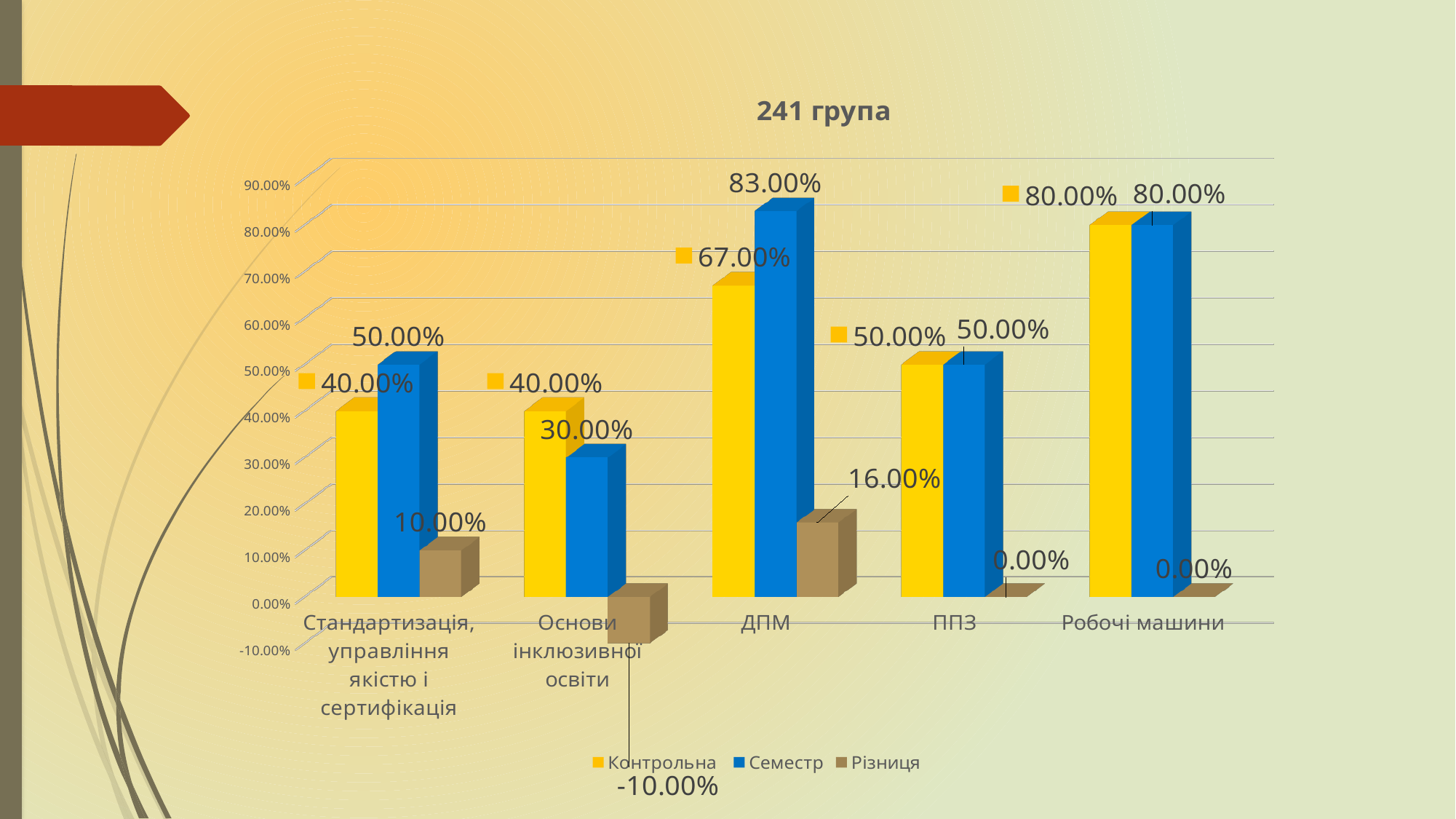
Which category has the highest Семестр value? ДПМ How many categories are shown on the x axis? 5 What is the Контрольна value for Основи інклюзивної освіти? 40.00% What type of chart is shown on the slide? bar chart What is the difference between the Семестр and Контрольна values for ДПМ? 16.00% Which is larger for Стандартизація, управління якістю і сертифікація: the Контрольна value or the Семестр value? Семестр What is the Різниця value for Робочі машини? 0.00% How many series does the legend list? 3 What is the Семестр value for ДПМ? 83.00% What is the title of the chart? 241 група Which category has the lowest Семестр value? Основи інклюзивної освіти What is the Різниця value for Основи інклюзивної освіти? -10.00%